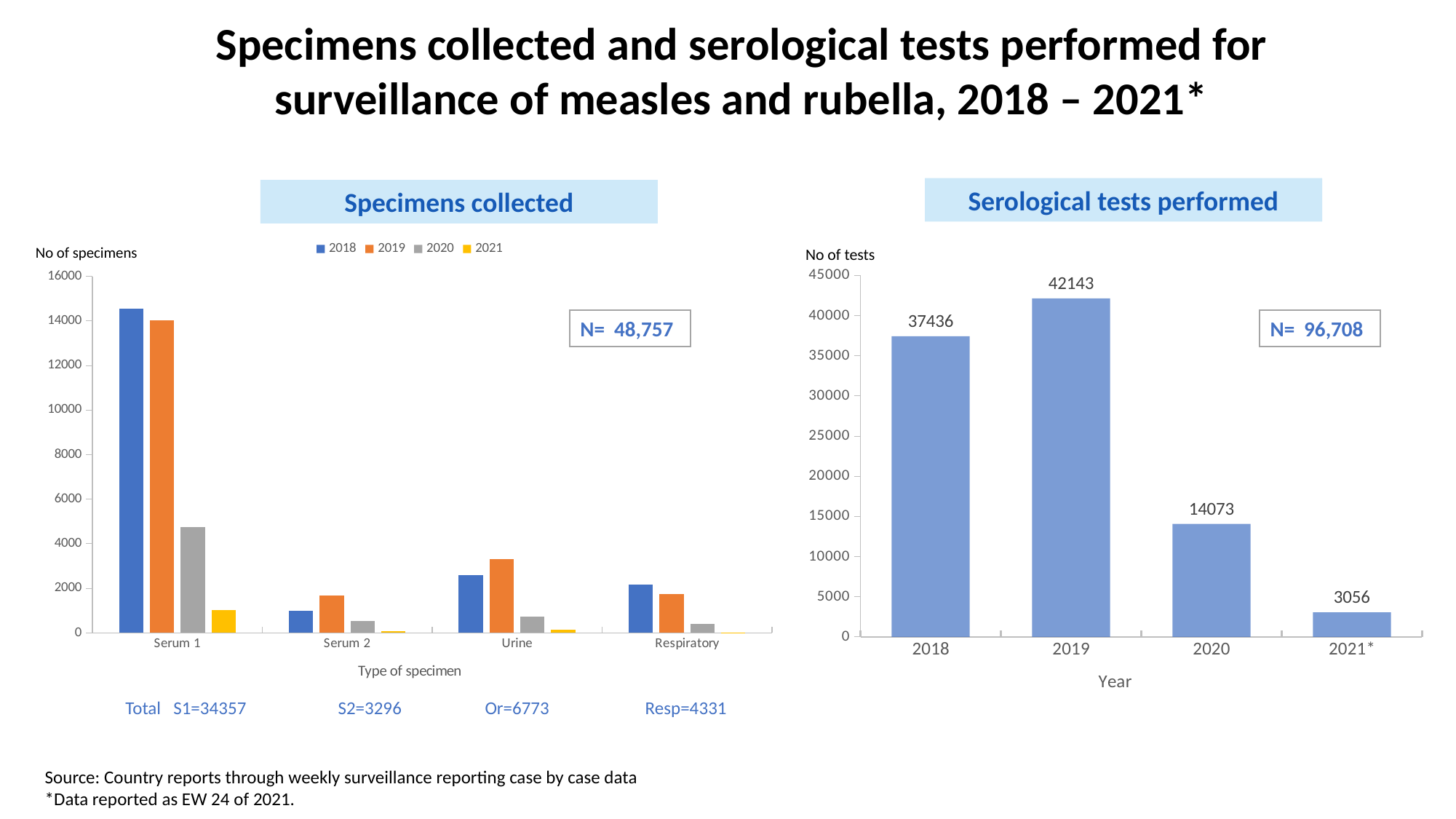
In the 'Specimens collected' chart, which specimen type has the highest 2019 value? Serum 1 In the 'Specimens collected' chart, what is the total N shown in the box? 48,757 In the 'Specimens collected' chart, is the 2019 value for Urine larger or smaller than the 2018 value for Urine? larger In the 'Specimens collected' chart, is the 2018 value for Serum 1 greater or less than 14000? greater In the 'Serological tests performed' chart, which year has the lowest number of tests? 2021* In the 'Specimens collected' chart, how many series does the legend list? 4 In the 'Serological tests performed' chart, which year has the highest number of tests? 2019 What kind of chart is the 'Serological tests performed' chart? bar chart In the 'Serological tests performed' chart, how many tests were performed in 2020? 14073 In the 'Serological tests performed' chart, how many tests were performed in 2019? 42143 In the 'Serological tests performed' chart, what is the difference between the number of tests in 2019 and 2018? 4707 In the 'Serological tests performed' chart, how many bars are plotted? 4